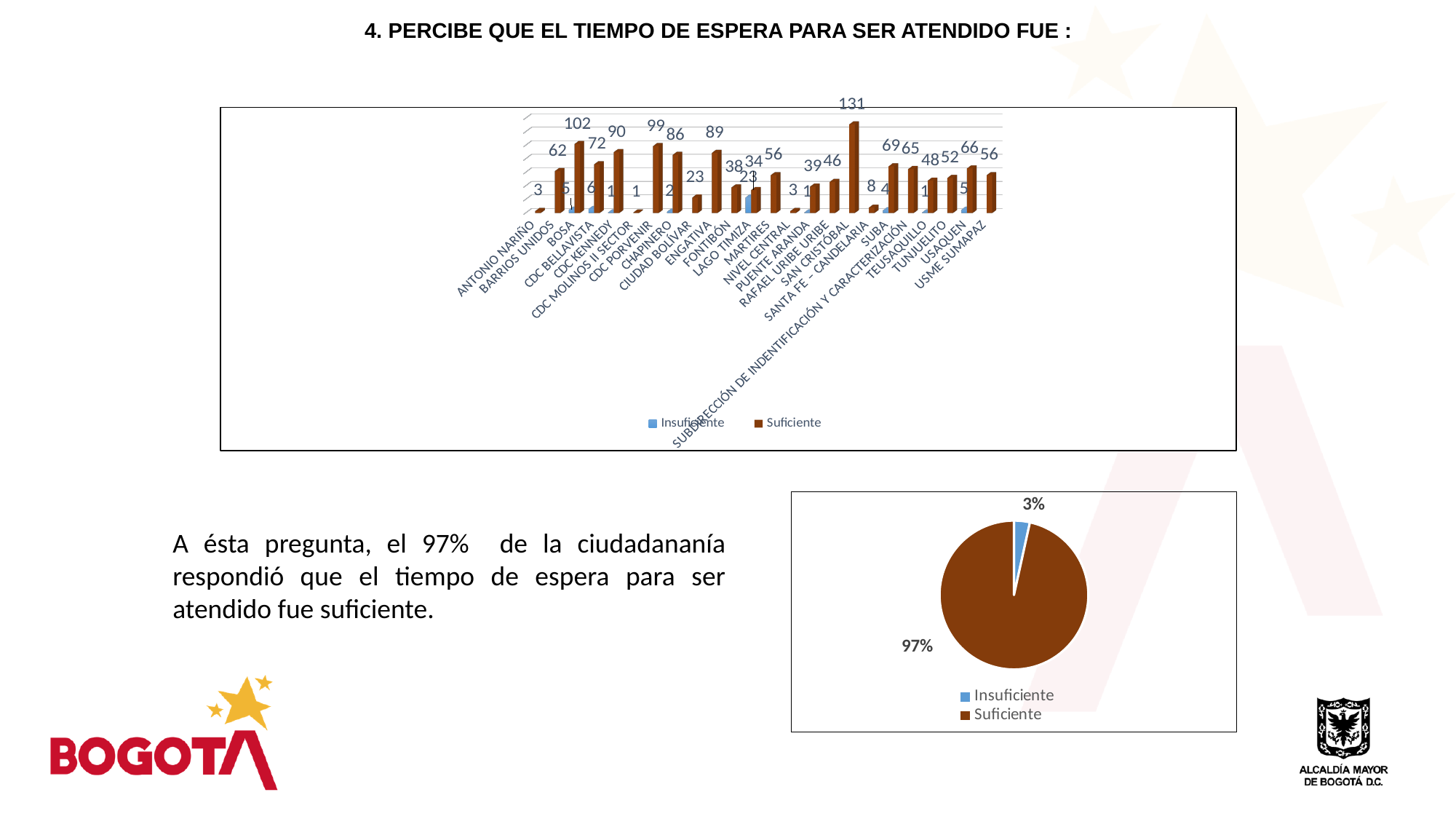
In the bar chart, which has a larger Suficiente value, CHAPINERO or SUBA? CHAPINERO How many series does the legend of the bar chart list? 2 In the pie chart, what share does Insuficiente have? 3% In the bar chart, what is the difference between the Suficiente values for BOSA and CDC PORVENIR? 3 What kind of chart is the lower-right chart on the slide? Pie chart In the bar chart, what is the Suficiente value for CDC KENNEDY? 90 In the pie chart, what share does Suficiente have? 97% In the bar chart, what is the Suficiente value for BOSA? 102 What kind of chart is the upper chart on the slide? Bar chart In the bar chart, which category has the highest Suficiente value? SAN CRISTOBAL How many categories are shown on the x axis of the bar chart? 24 In the bar chart, what is the Suficiente value for SAN CRISTOBAL? 131